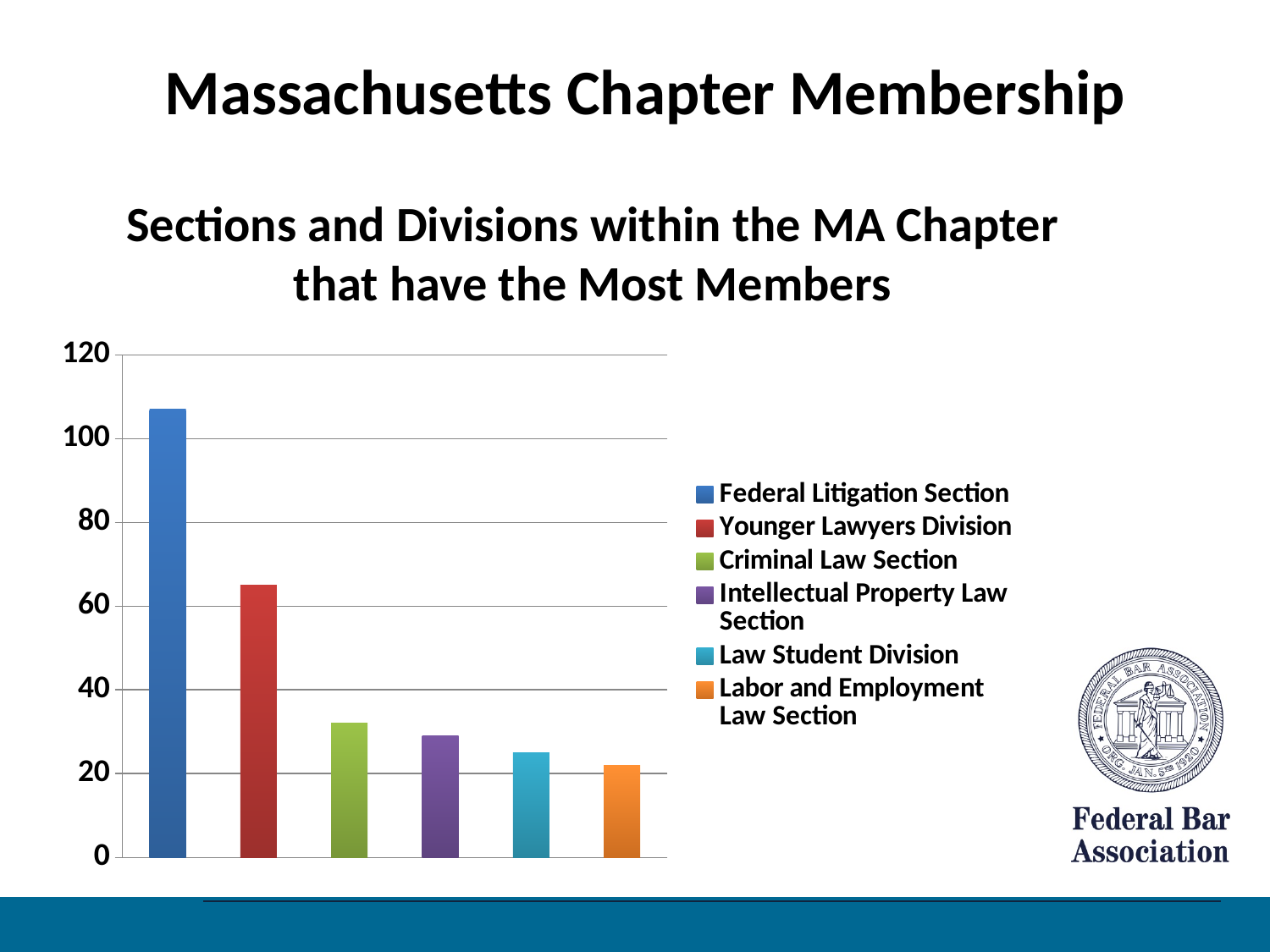
Is the value for the Younger Lawyers Division greater or less than 60? greater Which has more members, the Federal Litigation Section or the Younger Lawyers Division? Federal Litigation Section Which section or division has the highest number of members in the chart? Federal Litigation Section How many entries does the chart's legend list? 6 Which section or division has the lowest number of members in the chart? Labor and Employment Law Section What kind of chart is shown on the slide? bar chart Do the bar values rise or fall from left to right across the chart? fall How many bars are plotted in the chart? 6 Is the value for the Law Student Division greater or less than 20? greater Is the value for the Federal Litigation Section greater or less than 100? greater What is the title of the chart? Sections and Divisions within the MA Chapter that have the Most Members